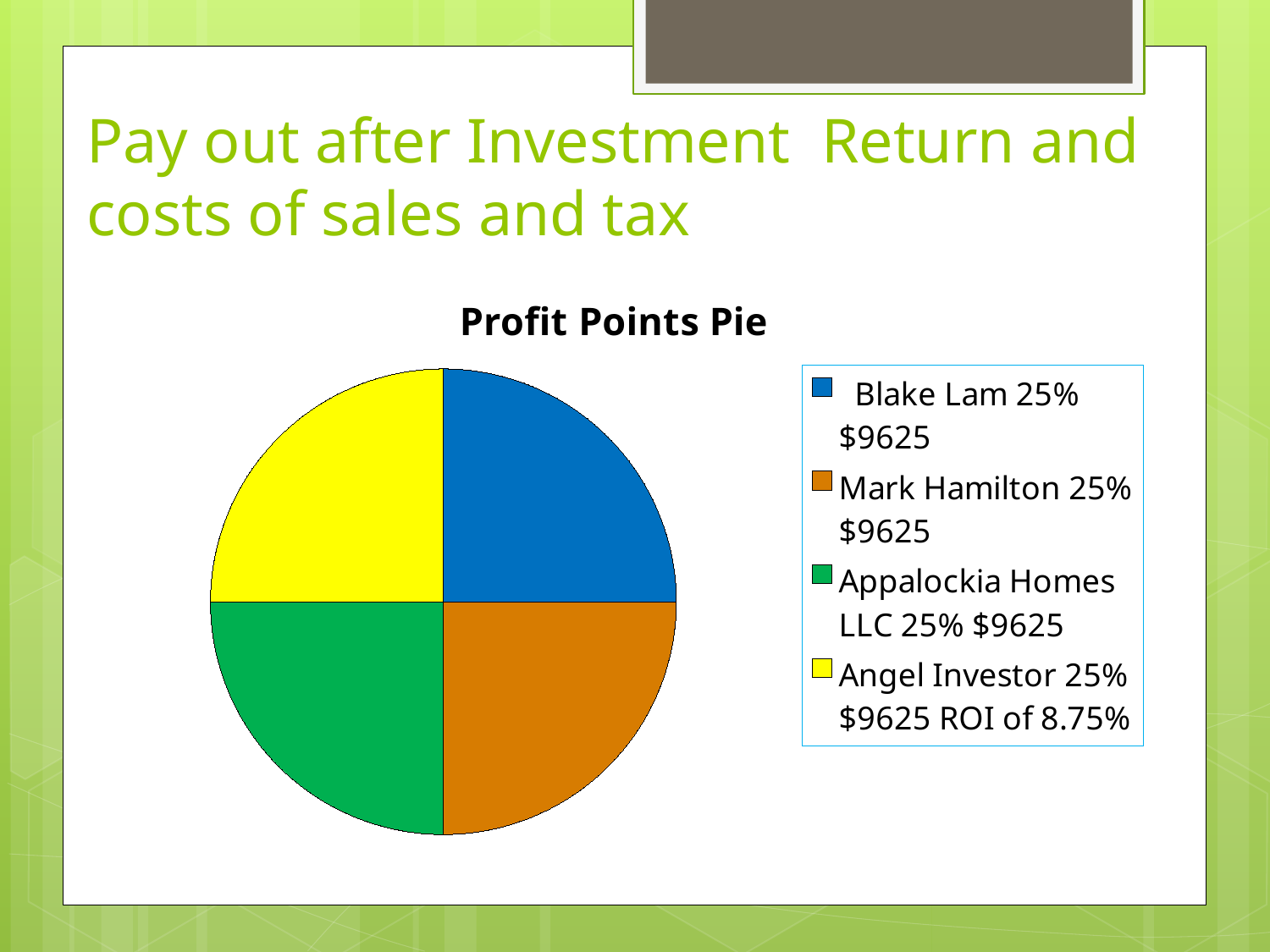
Is the share for Mark Hamilton greater or less than 50%? less What share of the pie does Blake Lam hold? 25% What dollar amount is listed for the Angel Investor in the legend? $9625 How many entries does the legend list? 4 What ROI is listed for the Angel Investor in the legend? 8.75% Which colour represents Blake Lam in the pie chart? Blue How many slices does the pie chart have? 4 What kind of chart is shown on the slide? Pie chart What share of the pie does Appalockia Homes LLC hold? 25% What dollar amount is listed for Mark Hamilton in the legend? $9625 What share of the pie does the Angel Investor hold? 25% What is the title of the chart? Profit Points Pie